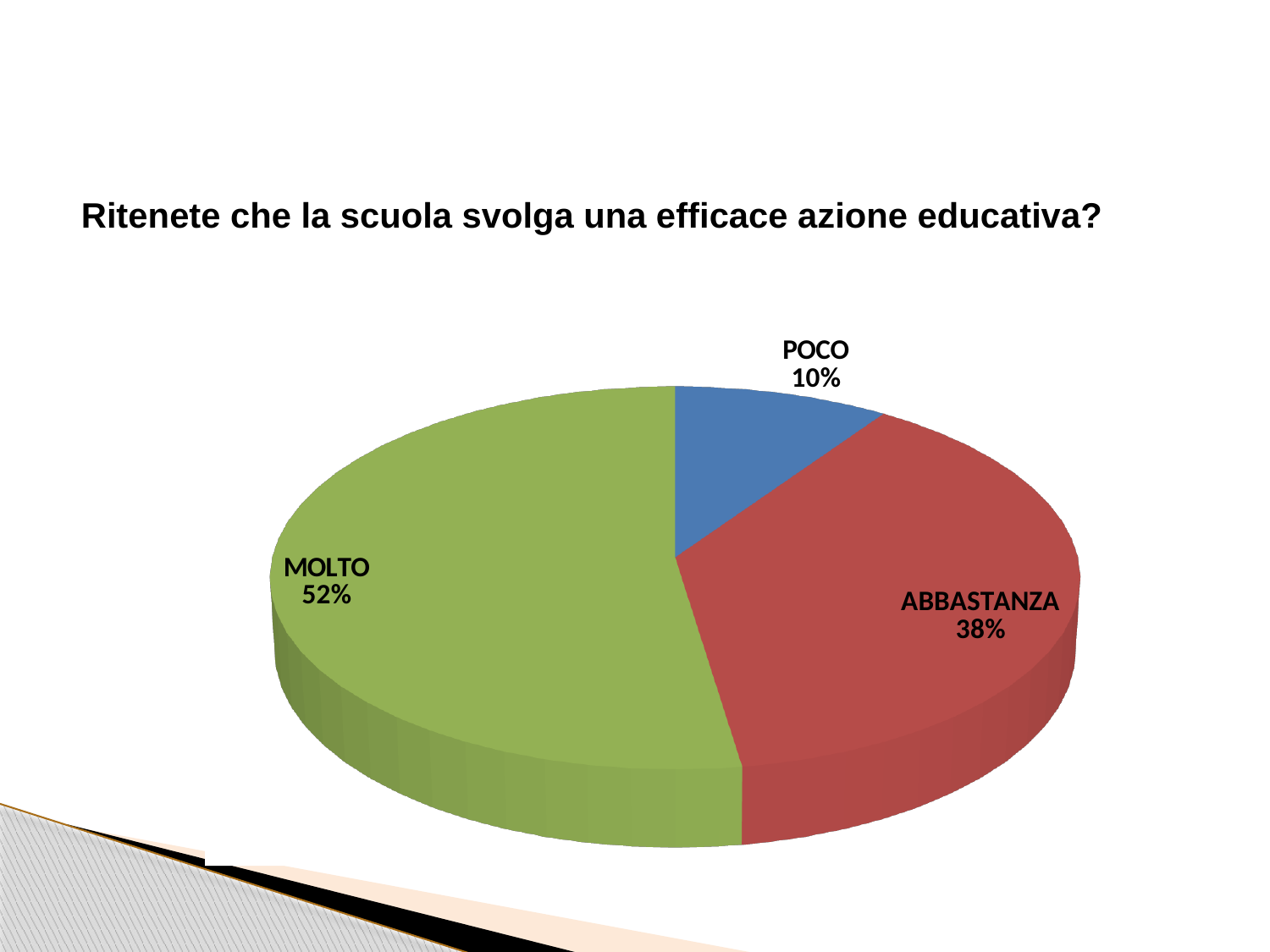
What percentage of respondents answered MOLTO? 52% What kind of chart is shown on the slide? pie chart What percentage of respondents answered ABBASTANZA? 38% What colour is the MOLTO slice? green Which is larger, the share for ABBASTANZA or the share for POCO? ABBASTANZA What question is shown as the title above the chart? Ritenete che la scuola svolga una efficace azione educativa? What is the difference in percentage points between MOLTO and ABBASTANZA? 14 How many slices does the pie chart have? 3 What is the difference in percentage points between ABBASTANZA and POCO? 28 Which response has the smallest share of the pie? POCO What percentage of respondents answered POCO? 10% Which response has the largest share of the pie? MOLTO